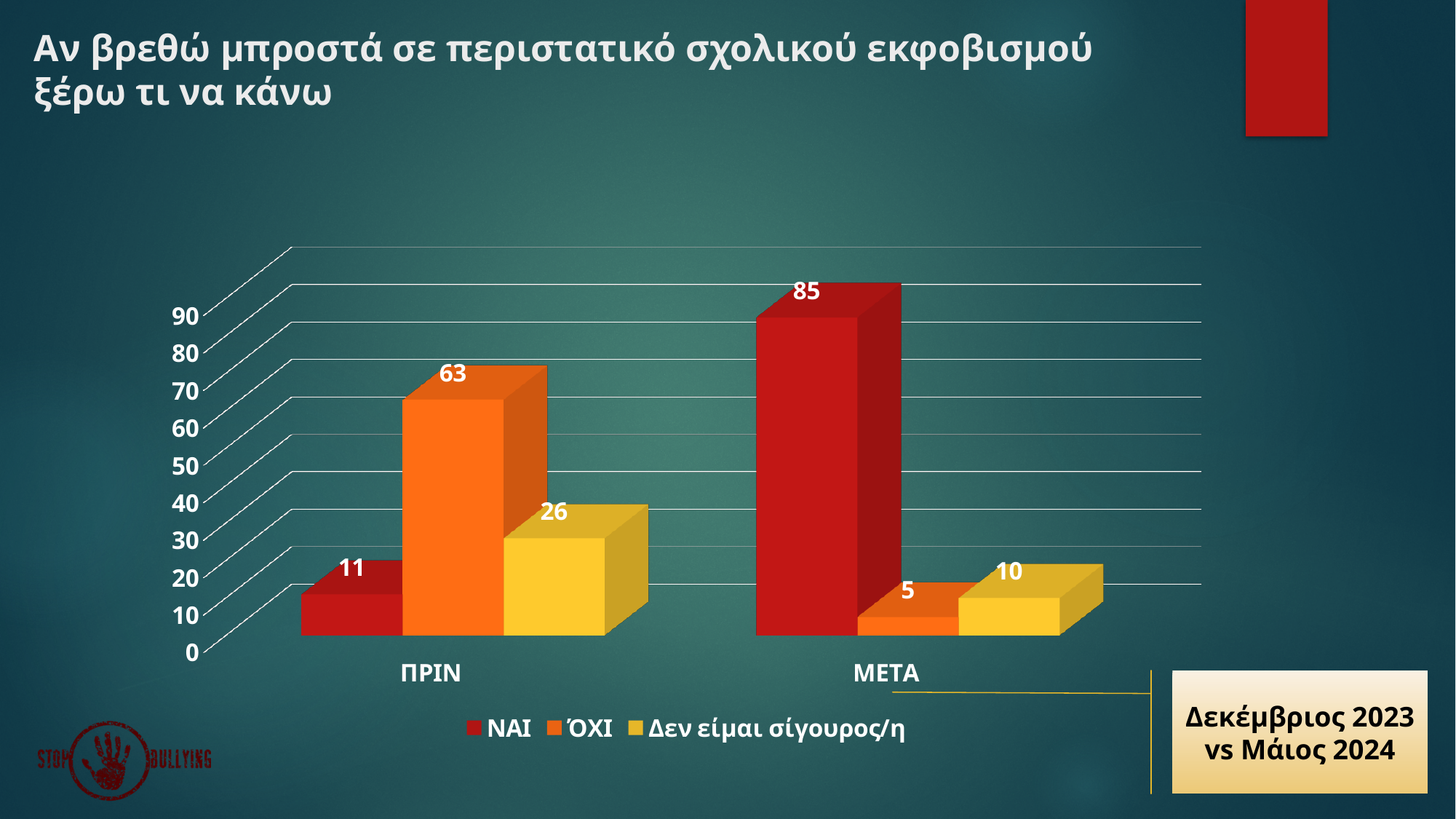
What colour represents the ΌΧΙ series? Orange What is the value for ΝΑΙ in the ΜΕΤΑ category? 85 What is the difference between the ΝΑΙ values for ΜΕΤΑ and ΠΡΙΝ? 74 Which is larger: ΌΧΙ in ΠΡΙΝ or ΌΧΙ in ΜΕΤΑ? ΌΧΙ in ΠΡΙΝ Which series has the lowest value in the ΠΡΙΝ category? ΝΑΙ How many categories are shown on the x axis? 2 What is the value for Δεν είμαι σίγουρος/η in the ΜΕΤΑ category? 10 What kind of chart is shown on the slide? Bar chart Which series has the highest value in the ΜΕΤΑ category? ΝΑΙ How many series does the legend list? 3 What is the value for ΌΧΙ in the ΠΡΙΝ category? 63 What is the value for ΝΑΙ in the ΠΡΙΝ category? 11